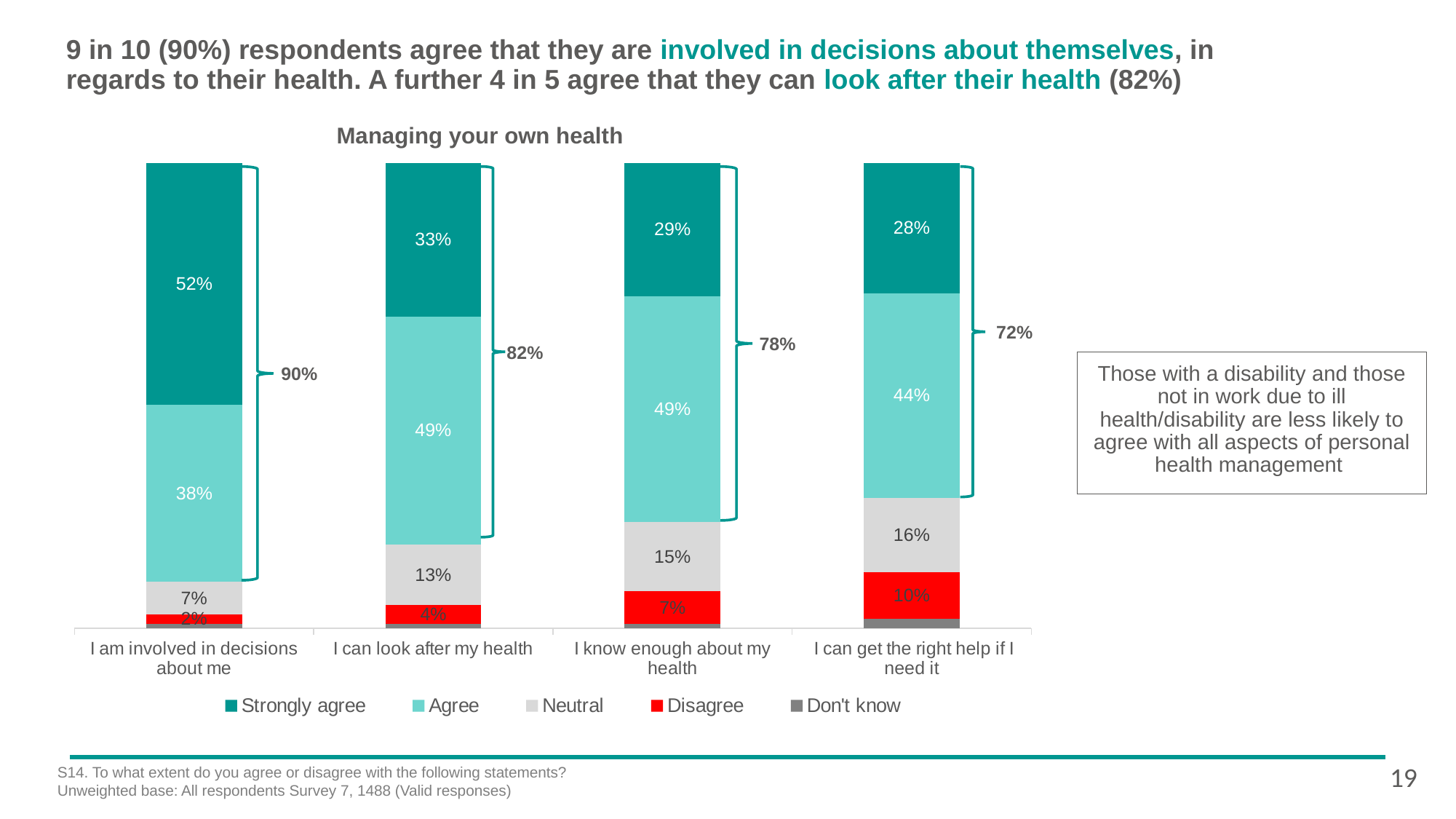
What percentage of respondents strongly agree with "I am involved in decisions about me"? 52% What is the Agree value for "I can look after my health"? 49% What is the Neutral value for "I know enough about my health"? 15% What combined agreement percentage (Strongly agree plus Agree) is shown by the bracket for "I know enough about my health"? 78% Which statement has the lowest Disagree value? I am involved in decisions about me What is the Disagree value for "I can get the right help if I need it"? 10% How many statements (categories) are shown on the x axis of the chart? 4 What is the difference between the Strongly agree values for "I am involved in decisions about me" and "I can look after my health"? 19% Which statement has the highest Strongly agree value? I am involved in decisions about me What kind of chart is shown under the title "Managing your own health"? Stacked bar chart Which is larger: the Neutral value for "I can get the right help if I need it" or the Neutral value for "I can look after my health"? I can get the right help if I need it How many series does the legend list? 5